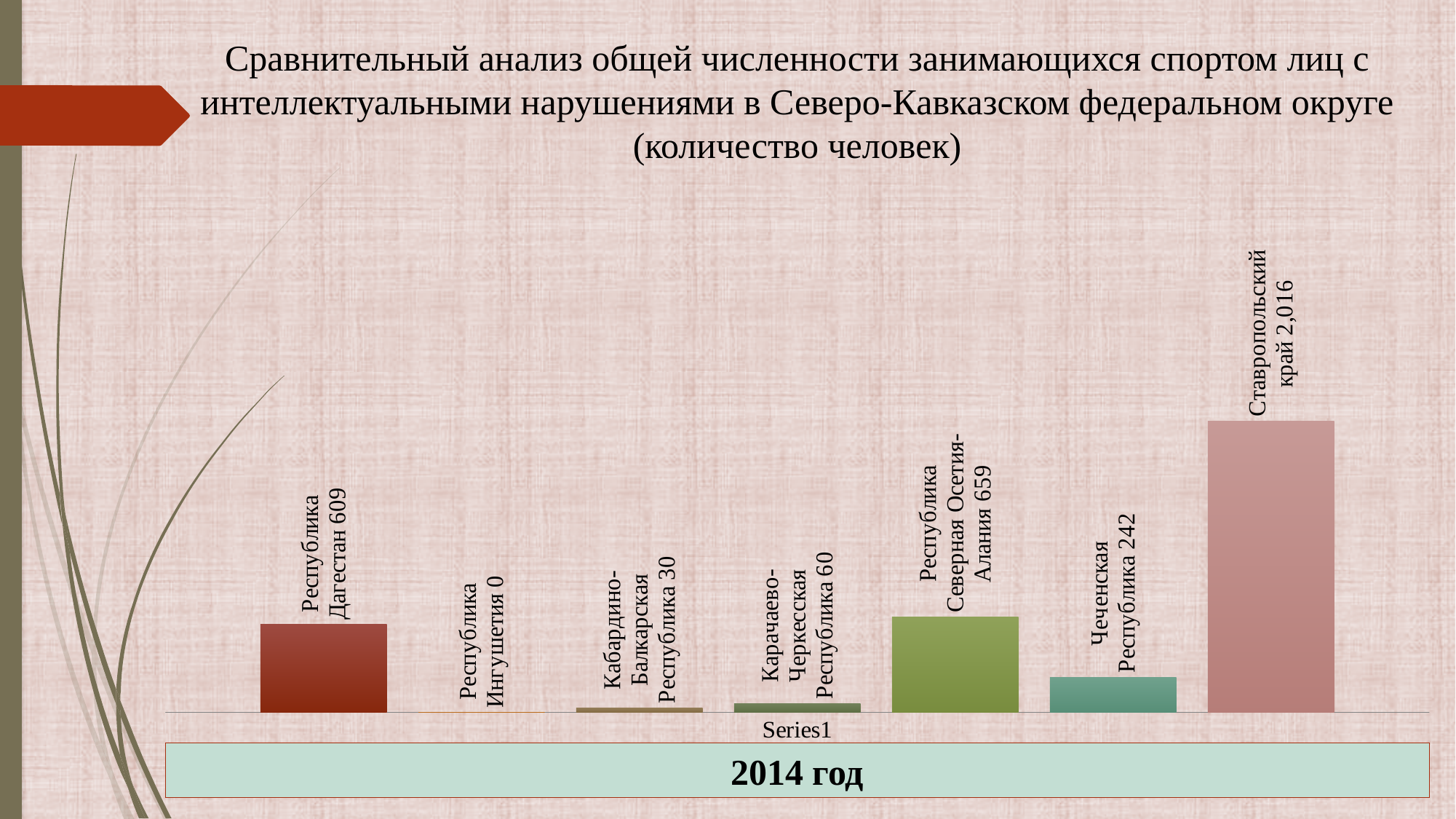
What is the value for Ставропольский край? 2,016 Which region has the highest value? Ставропольский край What kind of chart is shown on the slide? Bar chart How many regions are shown in the chart? 7 Which is larger, the value for Чеченская Республика or the value for Карачаево-Черкесская Республика? Чеченская Республика What is the difference between the values for Карачаево-Черкесская Республика and Кабардино-Балкарская Республика? 30 Which year does the chart refer to, according to the label below it? 2014 год What is the difference between the values for Республика Северная Осетия-Алания and Республика Дагестан? 50 What is the value for Республика Дагестан? 609 What is the value for Республика Ингушетия? 0 What is the value for Чеченская Республика? 242 Which region has the lowest value? Республика Ингушетия